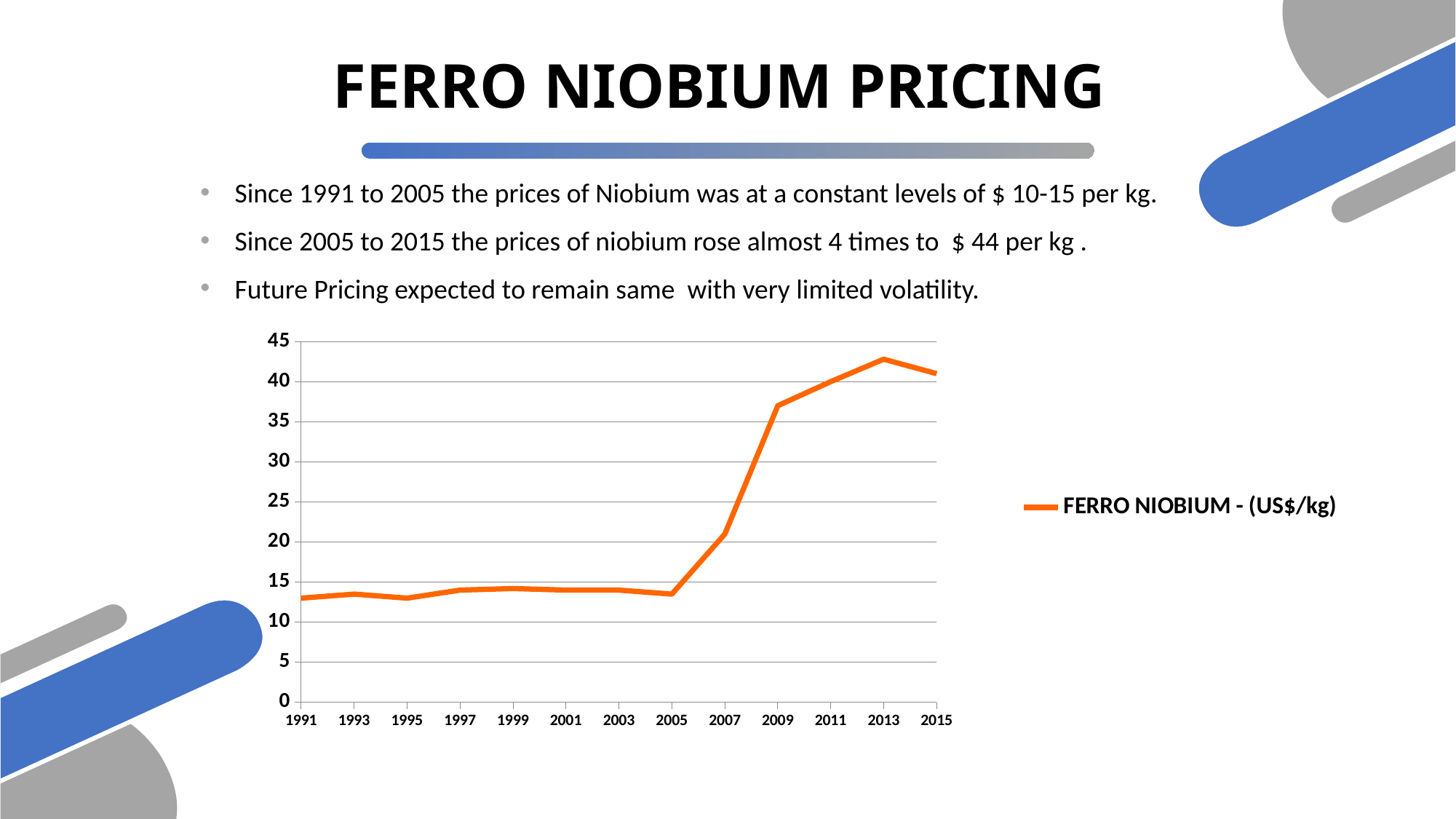
Is the value for 2013 greater or less than 40? greater Is the value for 2005 greater or less than 15? less Is the value for 2009 greater or less than 35? greater What is the name of the series shown in the chart legend? FERRO NIOBIUM - (US$/kg) How many series does the chart legend list? 1 How many years are labelled on the x axis of the chart? 13 What kind of chart is shown on the slide? line chart Does the ferro niobium price rise or fall between 2005 and 2013? rise In which year does the ferro niobium price reach its highest point on the chart? 2013 Does the ferro niobium price rise or fall between 2013 and 2015? fall Which year has the larger value, 2005 or 2009? 2009